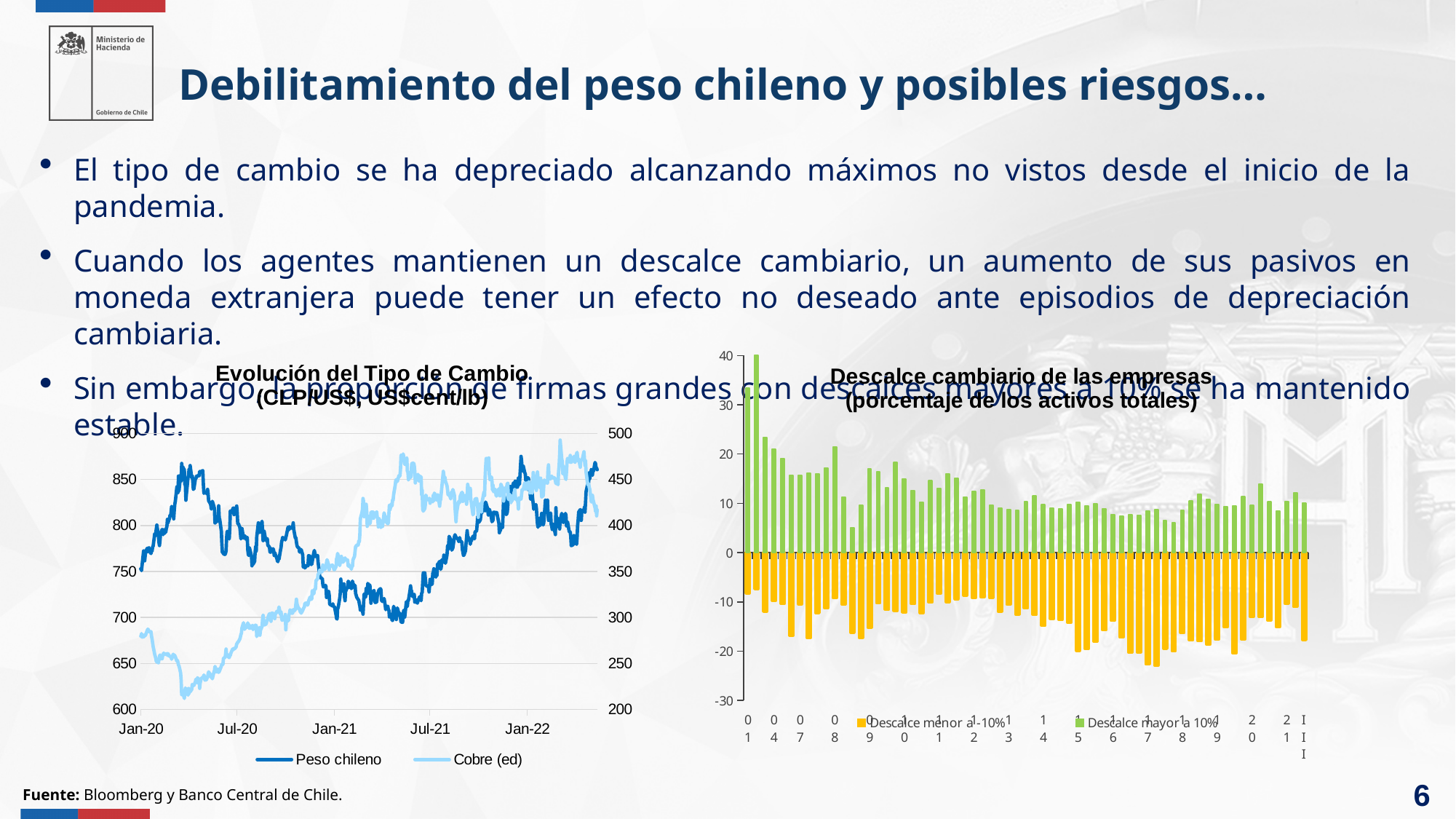
In the 'Descalce cambiario de las empresas' chart, is the first green bar (2001) greater or less than 30? greater In the 'Evolución del Tipo de Cambio' chart, is the lowest value of Cobre (ed) in 2020 greater or less than 250? less In the 'Descalce cambiario de las empresas' chart, is the lowest yellow bar (around 2017) greater or less than -20? less In the 'Descalce cambiario de las empresas' chart, which series is shown in green? Descalce mayor a 10% How many series does the legend of the 'Evolución del Tipo de Cambio' chart list? 2 In the 'Evolución del Tipo de Cambio' chart, does Cobre (ed) rise or fall overall between Jan-20 and Jan-22? rise In the 'Evolución del Tipo de Cambio' chart, what are the two series named in the legend? Peso chileno and Cobre (ed) What kind of chart is the 'Evolución del Tipo de Cambio' chart on the left? line chart How many series does the legend of the 'Descalce cambiario de las empresas' chart list? 2 What kind of chart is the 'Descalce cambiario de las empresas' chart on the right? bar chart